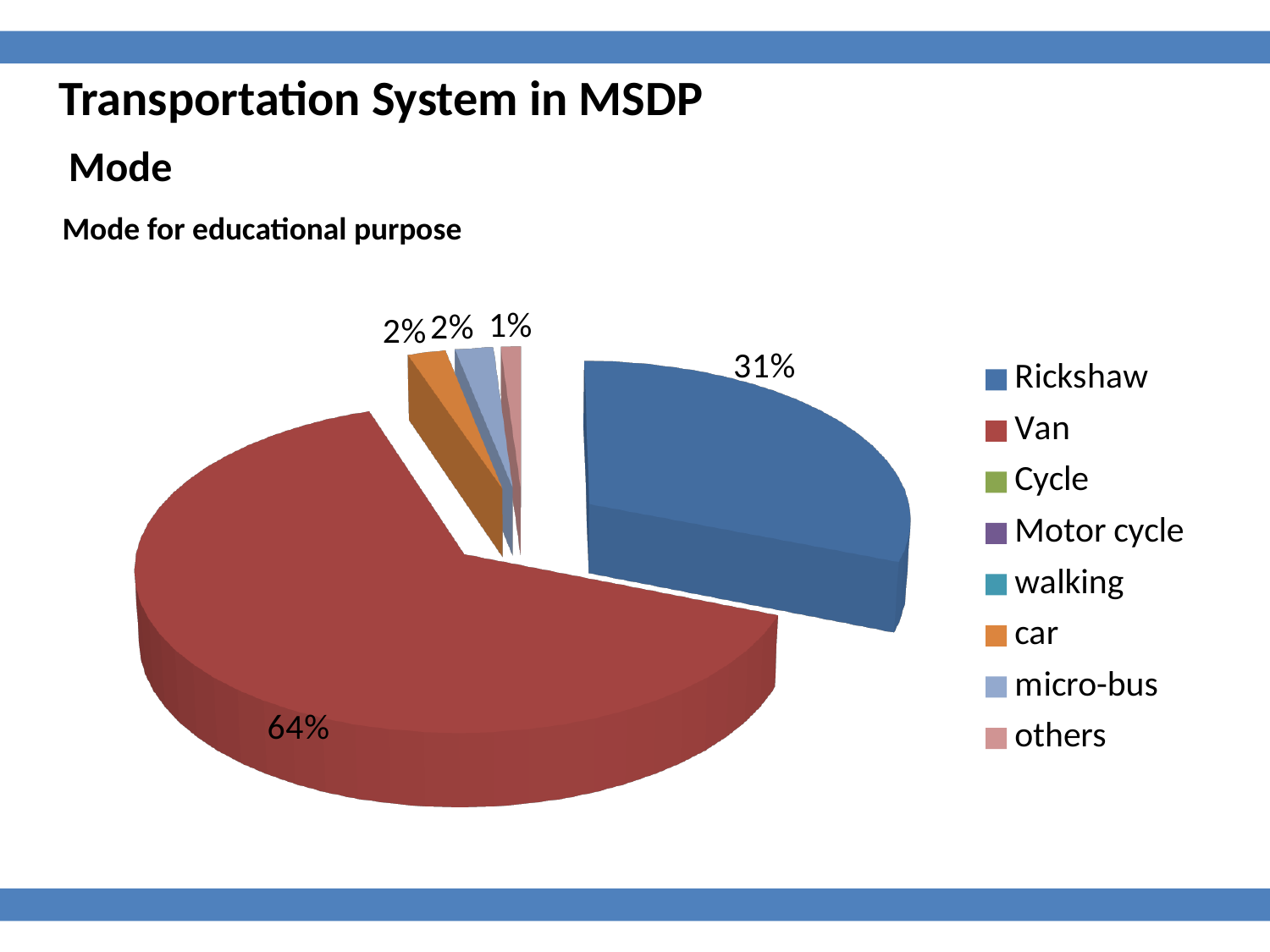
What percentage of the pie does car account for? 2% By how many percentage points does the Van share exceed the Rickshaw share? 33 percentage points Which is larger, the share for Rickshaw or the share for Van? Van What is the title of the chart? Mode for educational purpose What percentage of the pie does Van account for? 64% What percentage of the pie does the 'others' slice account for? 1% What percentage of the pie does micro-bus account for? 2% What colour represents Van in the pie chart? Red What percentage of the pie does Rickshaw account for? 31% What kind of chart is shown on the slide? Pie chart Which mode has the largest share of the pie? Van How many entries does the legend list? 8